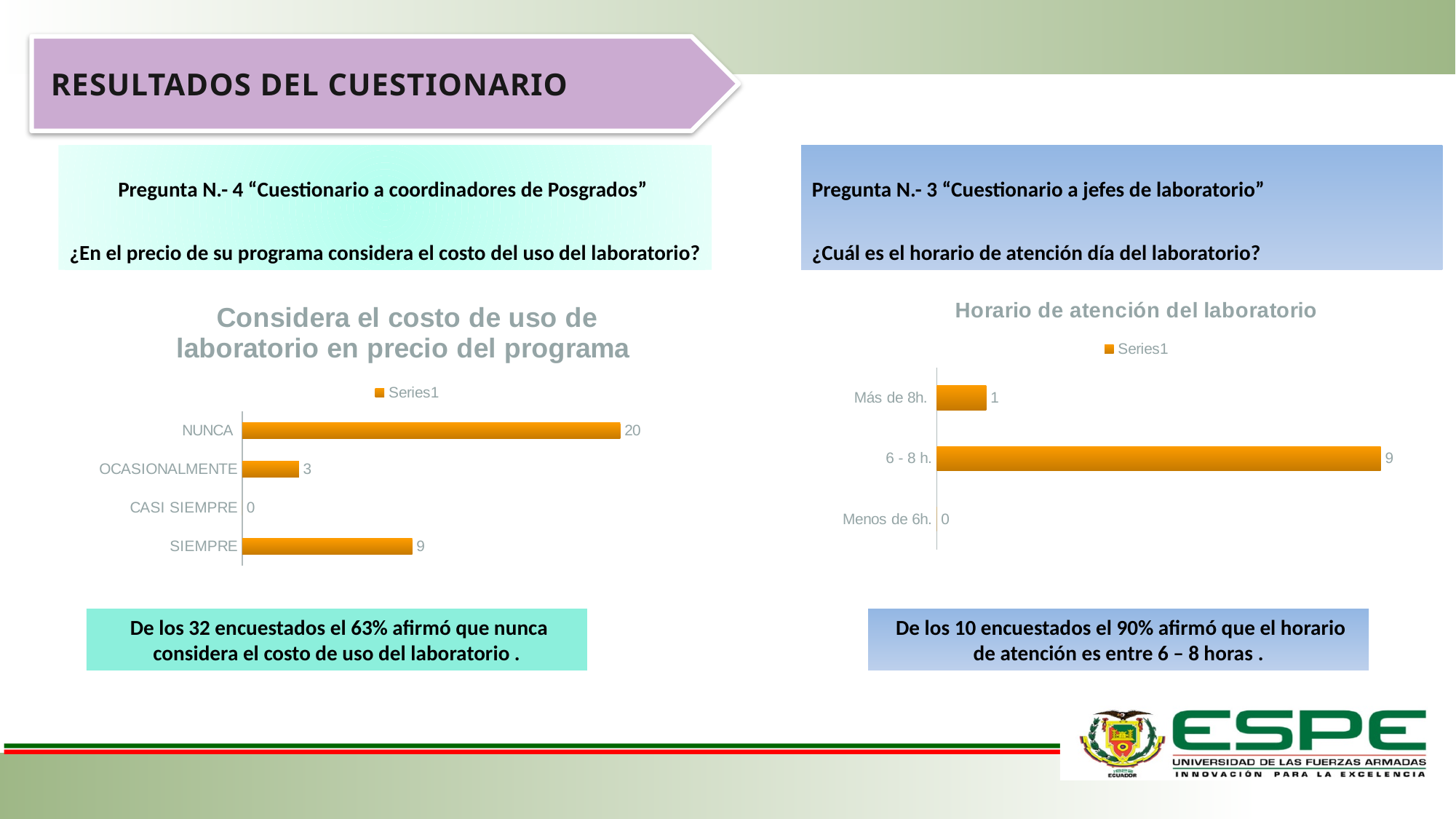
What kind of chart is the chart titled "Horario de atención del laboratorio"? bar chart In the chart titled "Considera el costo de uso de laboratorio en precio del programa", how many categories are shown? 4 In the chart titled "Considera el costo de uso de laboratorio en precio del programa", what is the difference between the values for NUNCA and SIEMPRE? 11 In the chart titled "Considera el costo de uso de laboratorio en precio del programa", what is the value for OCASIONALMENTE? 3 In the chart titled "Horario de atención del laboratorio", what is the value for 6 - 8 h.? 9 In the chart titled "Horario de atención del laboratorio", which category has the highest value? 6 - 8 h. In the chart titled "Considera el costo de uso de laboratorio en precio del programa", which category has the lowest value? CASI SIEMPRE In the chart titled "Considera el costo de uso de laboratorio en precio del programa", what is the value for NUNCA? 20 In the chart titled "Horario de atención del laboratorio", which is larger, the value for Más de 8h. or the value for Menos de 6h.? Más de 8h. In the chart titled "Horario de atención del laboratorio", how many series does the legend list? 1 In the chart titled "Horario de atención del laboratorio", what is the value for Más de 8h.? 1 In the chart titled "Considera el costo de uso de laboratorio en precio del programa", which category has the highest value? NUNCA